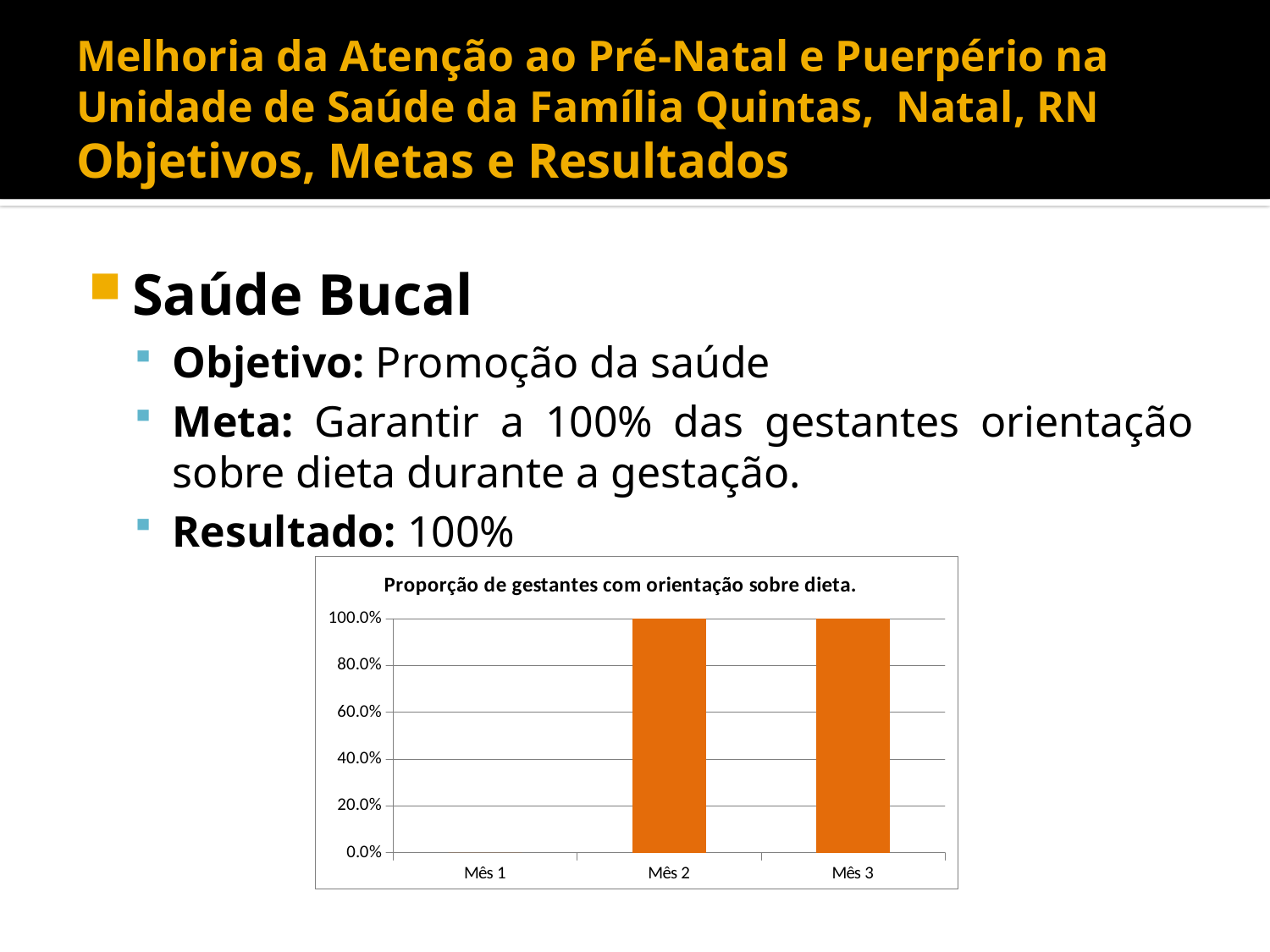
What is the value for Mês 1 in the chart? 0.0% Does the value rise or fall from Mês 1 to Mês 2? rise What is the difference between the values for Mês 2 and Mês 1? 100.0% Which category has the lowest value in the chart? Mês 1 What colour are the bars in the chart? orange Which is larger, the value for Mês 1 or the value for Mês 2? Mês 2 What is the value for Mês 2 in the chart? 100.0% What is the value for Mês 3 in the chart? 100.0% What kind of chart is shown on the slide? bar chart Is the value for Mês 3 greater or less than 80.0%? greater What is the title of the chart? Proporção de gestantes com orientação sobre dieta. How many categories are shown on the x axis of the chart? 3